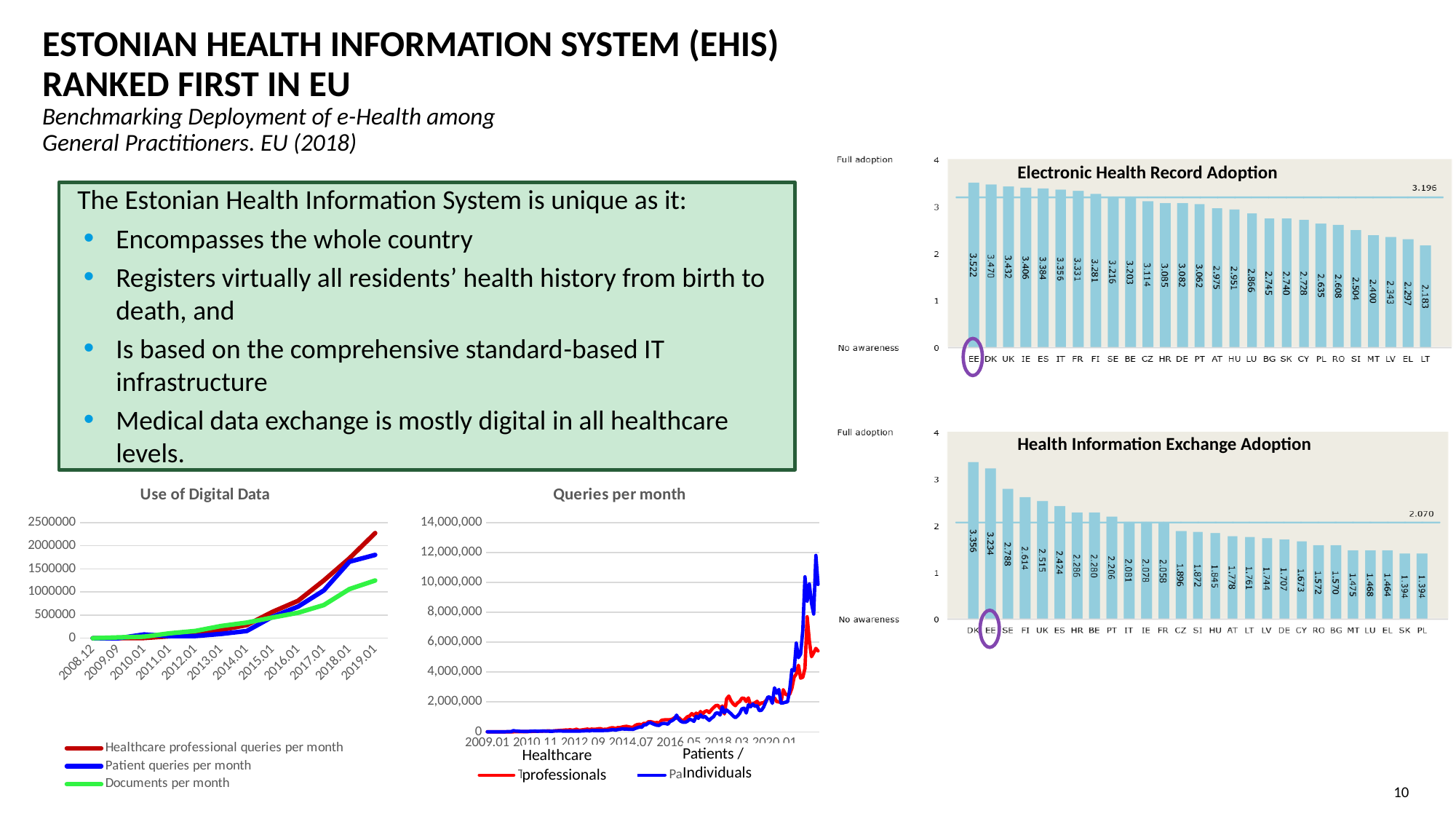
In the Health Information Exchange Adoption chart, what is the value for DK? 3.356 How many series does the legend of the Use of Digital Data chart list? 3 In the Electronic Health Record Adoption chart, which country has the highest value? EE In the Electronic Health Record Adoption chart, what is the value for EE? 3.522 In the Health Information Exchange Adoption chart, which has the larger value, SE or FI? SE In the Use of Digital Data chart, do the values generally rise or fall from 2008.12 to 2019.01? Rise In the Health Information Exchange Adoption chart, what is the difference between the values for DK and EE? 0.122 In the Electronic Health Record Adoption chart, how many countries are shown? 27 In the Health Information Exchange Adoption chart, which country has the highest value? DK In the Electronic Health Record Adoption chart, which country has the lowest value? LT What kind of chart is the Queries per month chart? Line chart In the Electronic Health Record Adoption chart, what is the difference between the values for EE and DK? 0.052